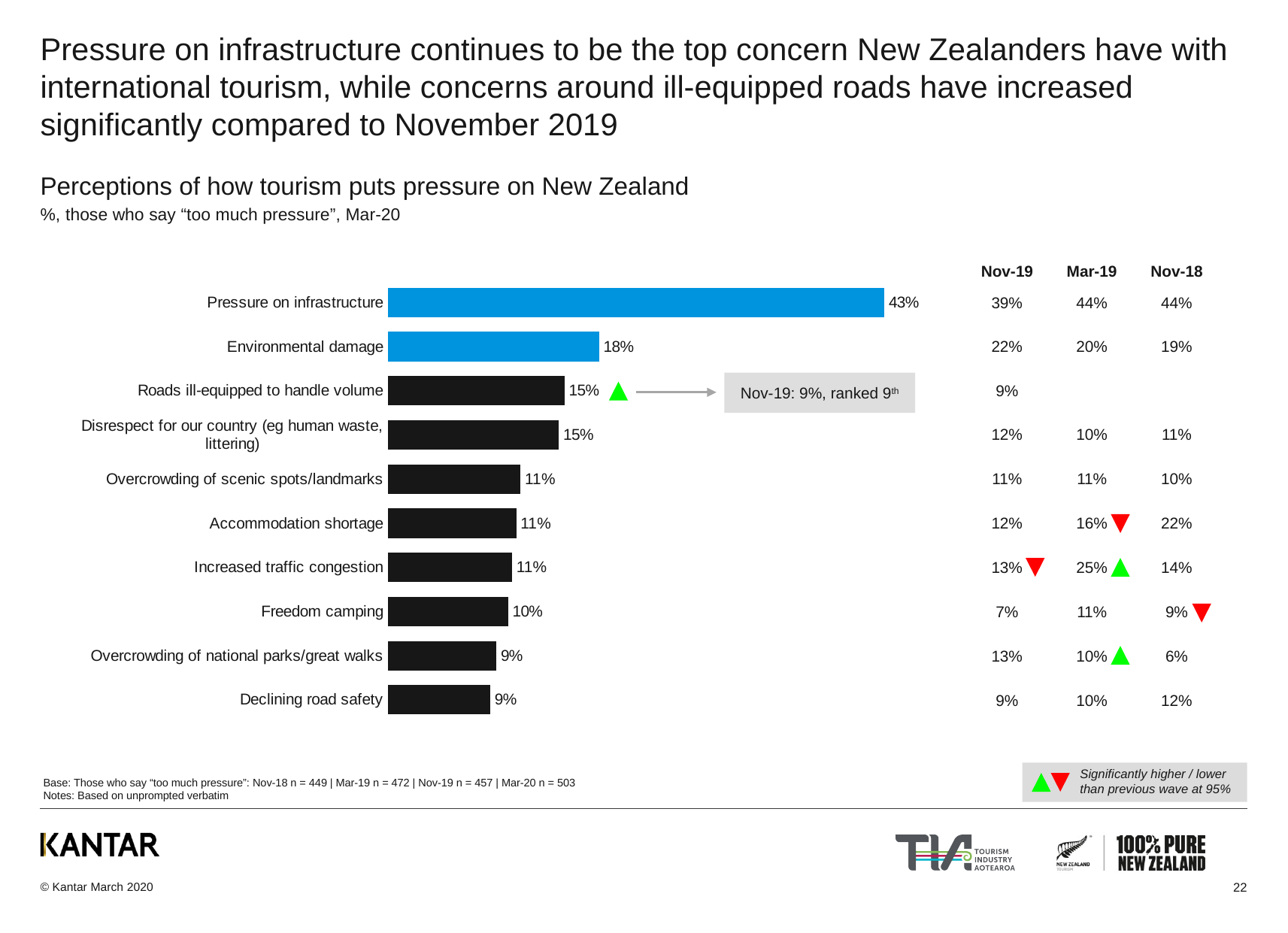
What kind of chart is shown on the slide? Bar chart Which two bars in the chart are coloured blue? Pressure on infrastructure and Environmental damage What is the value for Environmental damage? 18% What is the difference between the values for Pressure on infrastructure and Environmental damage? 25% What is the title of the chart? Perceptions of how tourism puts pressure on New Zealand Which category has the highest value? Pressure on infrastructure How many categories are shown in the bar chart? 10 Which is larger, the value for Environmental damage or the value for Overcrowding of scenic spots/landmarks? Environmental damage What is the value for Freedom camping? 10% What is the value for Pressure on infrastructure? 43% What is the value for Roads ill-equipped to handle volume? 15% What is the difference between the values for Roads ill-equipped to handle volume and Declining road safety? 6%